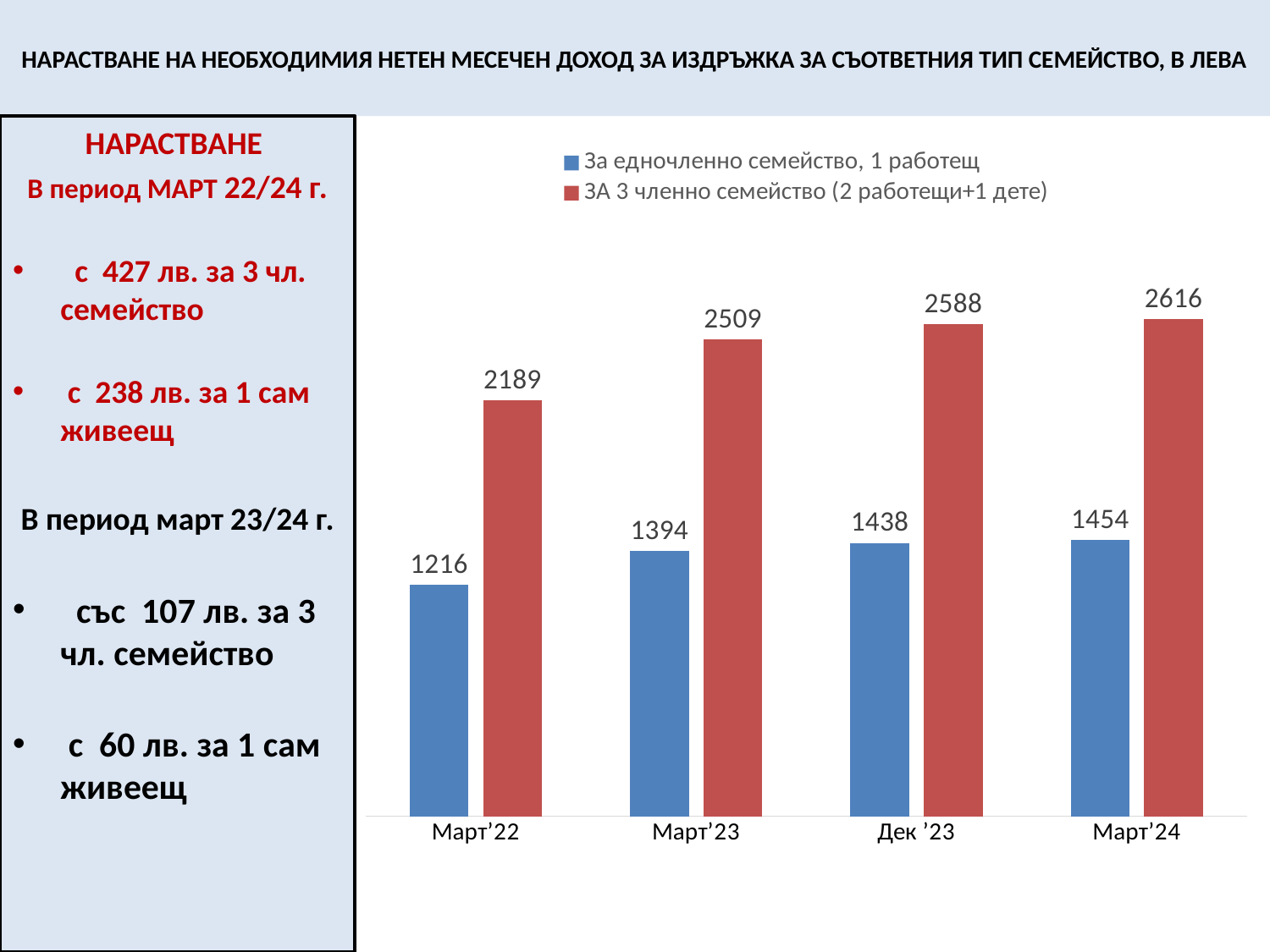
Which is larger: the "За едночленно семейство, 1 работещ" value in Дек '23 or in Март'23? Дек '23 What kind of chart is shown? bar chart What is the difference between the "За едночленно семейство, 1 работещ" values in Март'23 and Март'22? 178 How many series does the legend list? 2 In which period is the value for "ЗА 3 членно семейство (2 работещи+1 дете)" lowest? Март'22 What is the value for "ЗА 3 членно семейство (2 работещи+1 дете)" in Дек '23? 2588 Do the values for "ЗА 3 членно семейство (2 работещи+1 дете)" rise or fall from Март'22 to Март'24? rise In which period is the value for "За едночленно семейство, 1 работещ" highest? Март'24 What is the value for "За едночленно семейство, 1 работещ" in Март'22? 1216 What is the value for "ЗА 3 членно семейство (2 работещи+1 дете)" in Март'24? 2616 How many periods are shown on the x axis? 4 What is the difference between the "ЗА 3 членно семейство (2 работещи+1 дете)" values in Март'24 and Март'22? 427